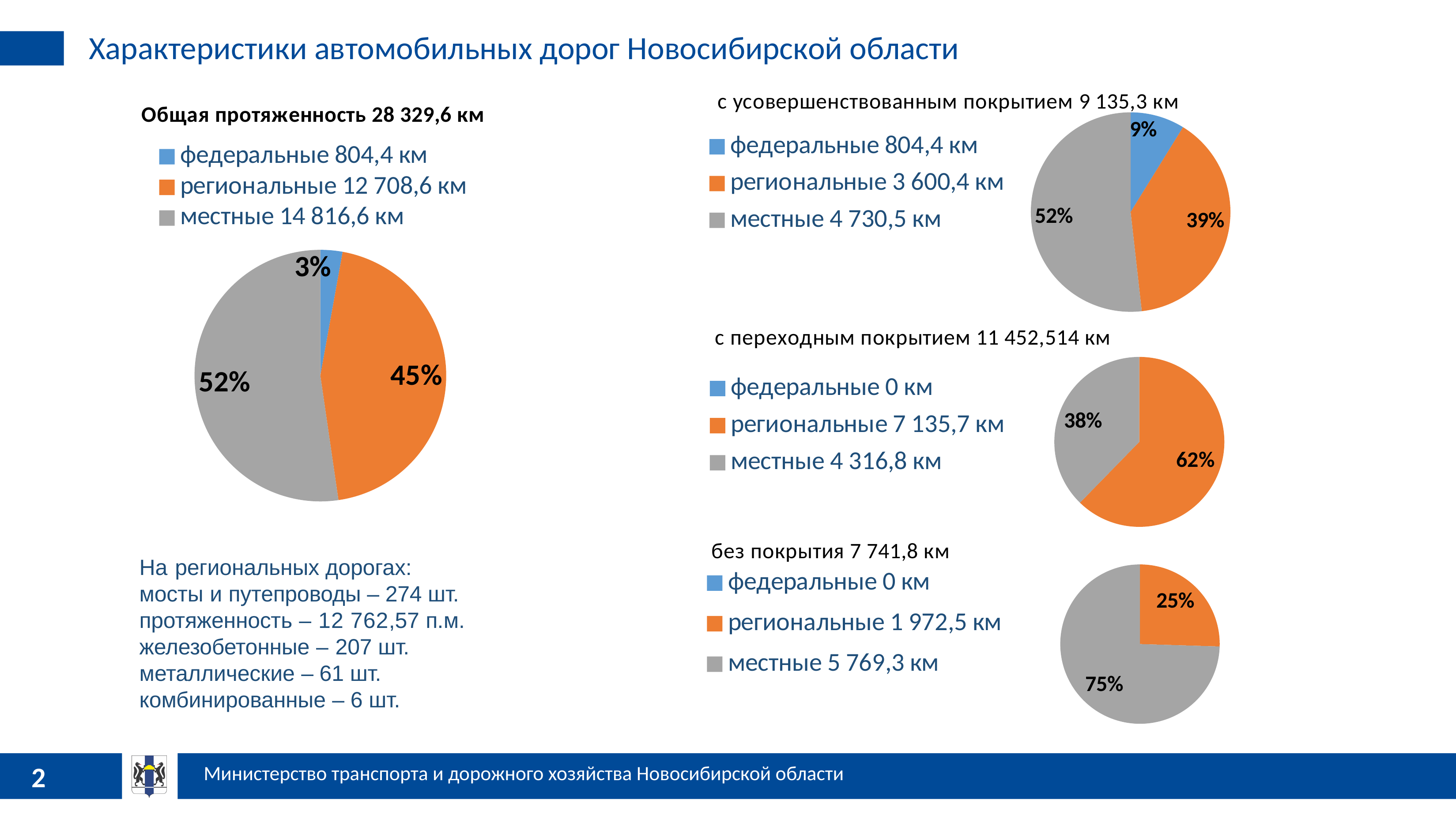
In the "с переходным покрытием 11 452,514 км" pie chart, what share is labelled for местные roads? 38% In the "без покрытия 7 741,8 км" pie chart, what is the length of региональные roads shown in the legend? 1 972,5 км How many categories does the legend of the "без покрытия 7 741,8 км" pie chart list? 3 In the "Общая протяженность 28 329,6 км" pie chart, which category has the smallest slice? федеральные In the "Общая протяженность 28 329,6 км" pie chart, what share of the pie do местные roads take? 52% In the "с усовершенствованным покрытием 9 135,3 км" pie chart, what share is labelled for федеральные roads? 9% In the "с усовершенствованным покрытием 9 135,3 км" pie chart, what is the length of местные roads shown in the legend? 4 730,5 км In the "с переходным покрытием 11 452,514 км" pie chart, what colour represents региональные roads? orange What kind of chart is used for "с усовершенствованным покрытием 9 135,3 км"? pie chart In the "с переходным покрытием 11 452,514 км" pie chart, which category has the largest slice? региональные In the "Общая протяженность 28 329,6 км" pie chart, what is the length of региональные roads shown in the legend? 12 708,6 км In the "без покрытия 7 741,8 км" pie chart, is the slice for местные roads larger or smaller than the slice for региональные roads? larger